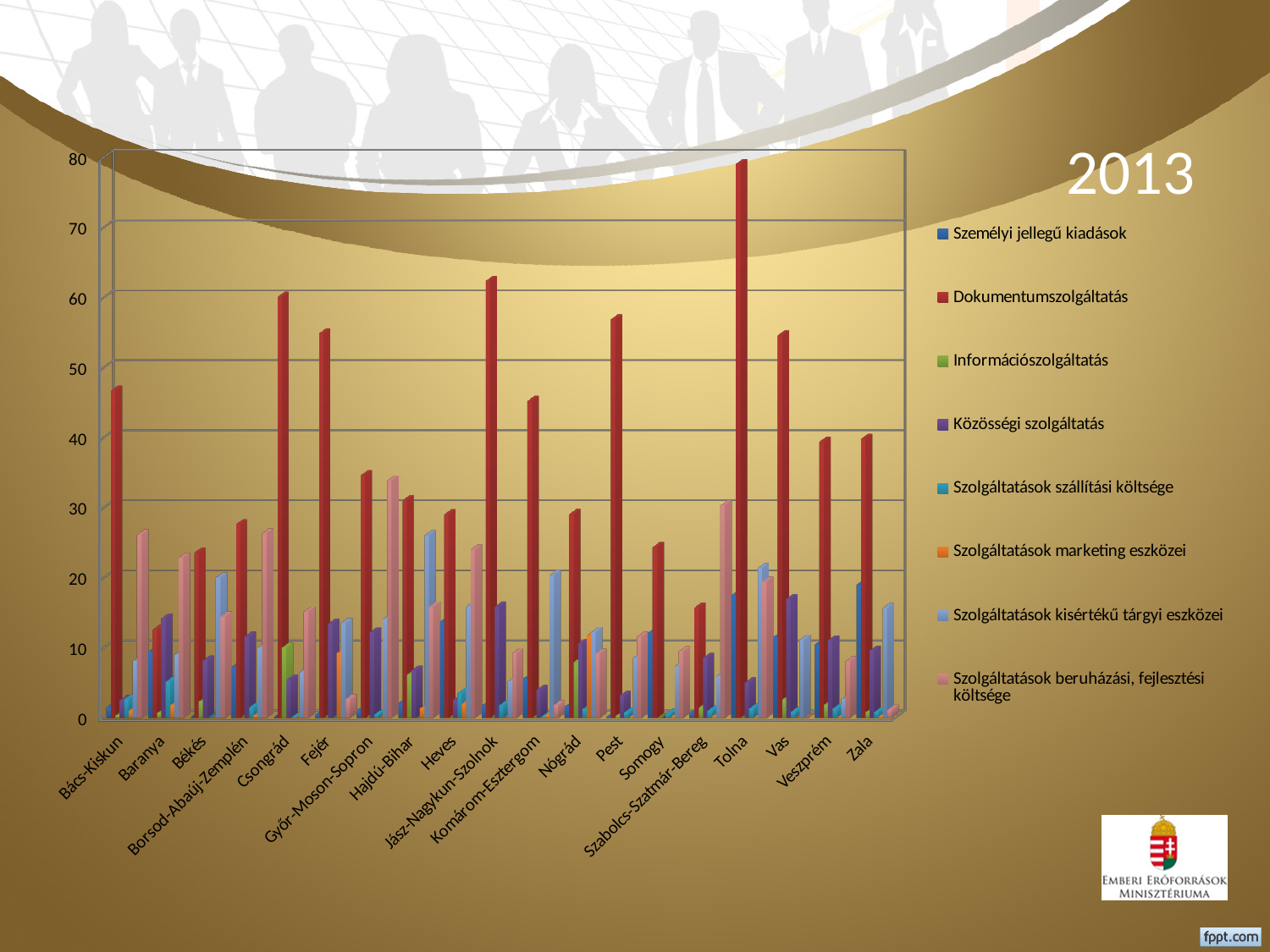
Is the Dokumentumszolgáltatás value for Bács-Kiskun greater or less than 40? greater How many counties (categories) are shown on the x axis? 19 Which county has the highest value for Dokumentumszolgáltatás? Tolna Which has the larger Dokumentumszolgáltatás value, Csongrád or Baranya? Csongrád Which colour represents Dokumentumszolgáltatás in the legend? red Is the Dokumentumszolgáltatás value for Szabolcs-Szatmár-Bereg greater or less than 20? less What is the title of the chart? 2013 Is the Dokumentumszolgáltatás value for Tolna greater or less than 70? greater How many series does the legend list? 8 Which has the larger Dokumentumszolgáltatás value, Tolna or Vas? Tolna What kind of chart is shown on the slide? bar chart